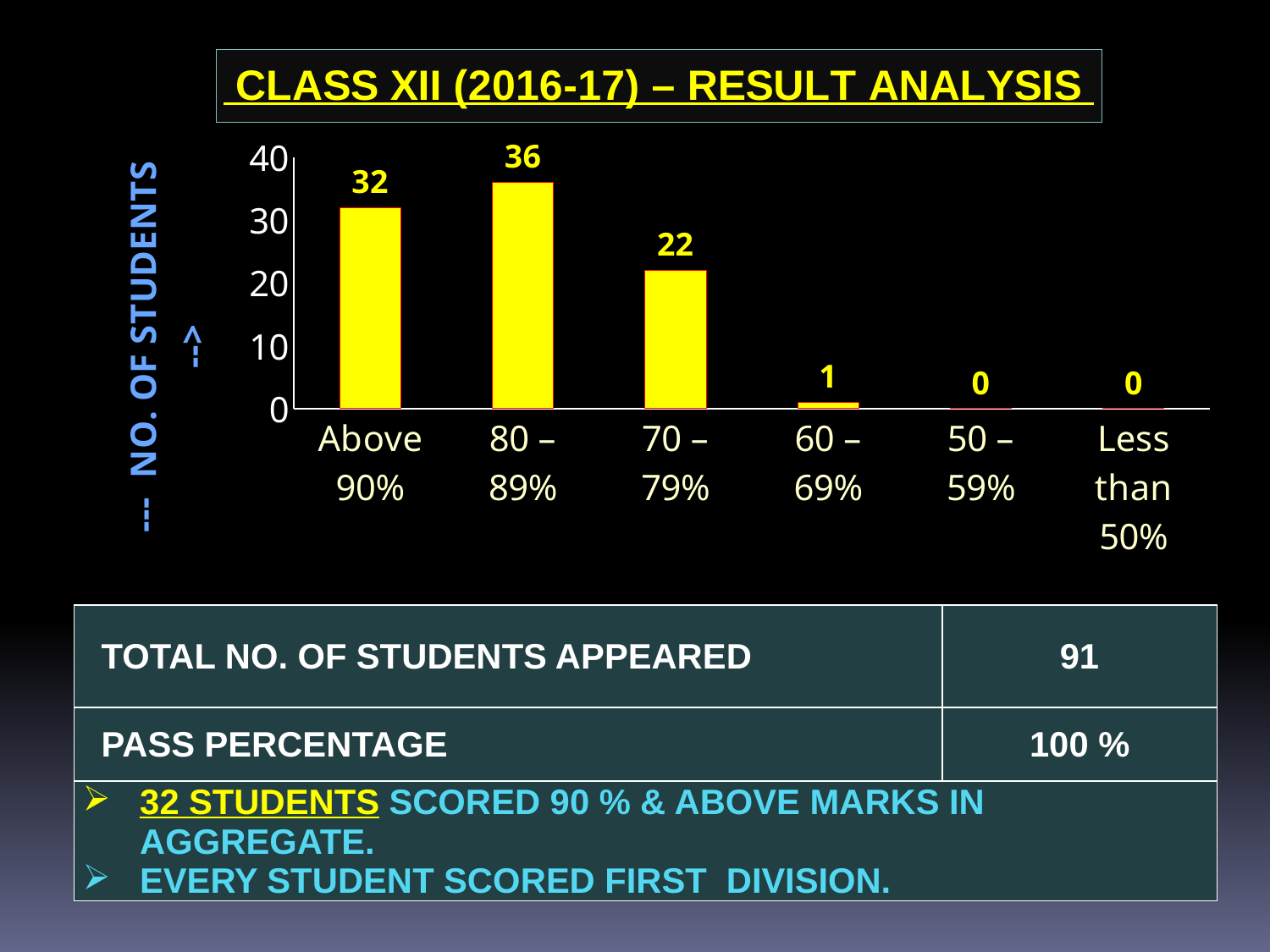
How many students scored in the 60 – 69% range? 1 What kind of chart is shown on the slide? bar chart How many students scored in the 50 – 59% range? 0 How many students scored in the 80 – 89% range? 36 Which category has the highest number of students? 80 – 89% How many categories are shown on the x axis of the chart? 6 Is the value for the 70 – 79% category greater or less than 30? less What is the label of the vertical axis of the chart? NO. OF STUDENTS What is the difference between the number of students in the 80 – 89% range and the 70 – 79% range? 14 What is the number of students for the Above 90% category? 32 What is the total number of students in the Above 90% and 80 – 89% categories combined? 68 Which has more students: Above 90% or 70 – 79%? Above 90%